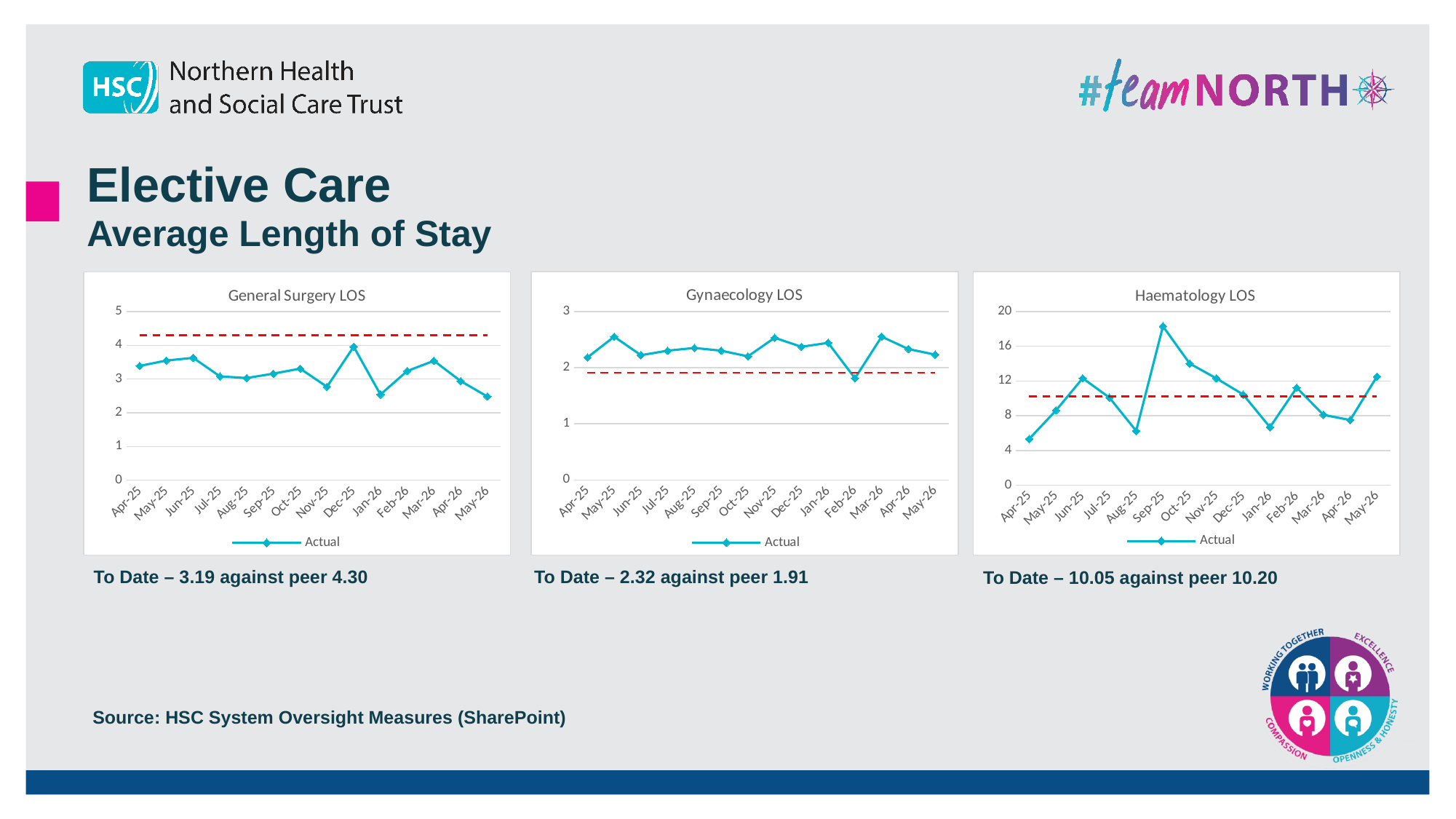
In the Haematology LOS chart, is the value for Sep-25 greater or less than 16? greater In the Haematology LOS chart, which is larger, the value for Oct-25 or the value for Jan-26? Oct-25 How many series does the legend of the Gynaecology LOS chart list? 1 In the Haematology LOS chart, which month has the lowest value? Apr-25 In the General Surgery LOS chart, which month has the highest value? Dec-25 In the Gynaecology LOS chart, which month has the lowest value? Feb-26 In the Haematology LOS chart, which month has the highest value? Sep-25 In the General Surgery LOS chart, is the value for Jan-26 greater or less than 3? less What kind of chart is the General Surgery LOS chart? line chart How many months are plotted in the General Surgery LOS chart? 14 What is the title of the chart on the right of the slide? Haematology LOS In the Gynaecology LOS chart, is the value for Apr-25 greater or less than 2? greater